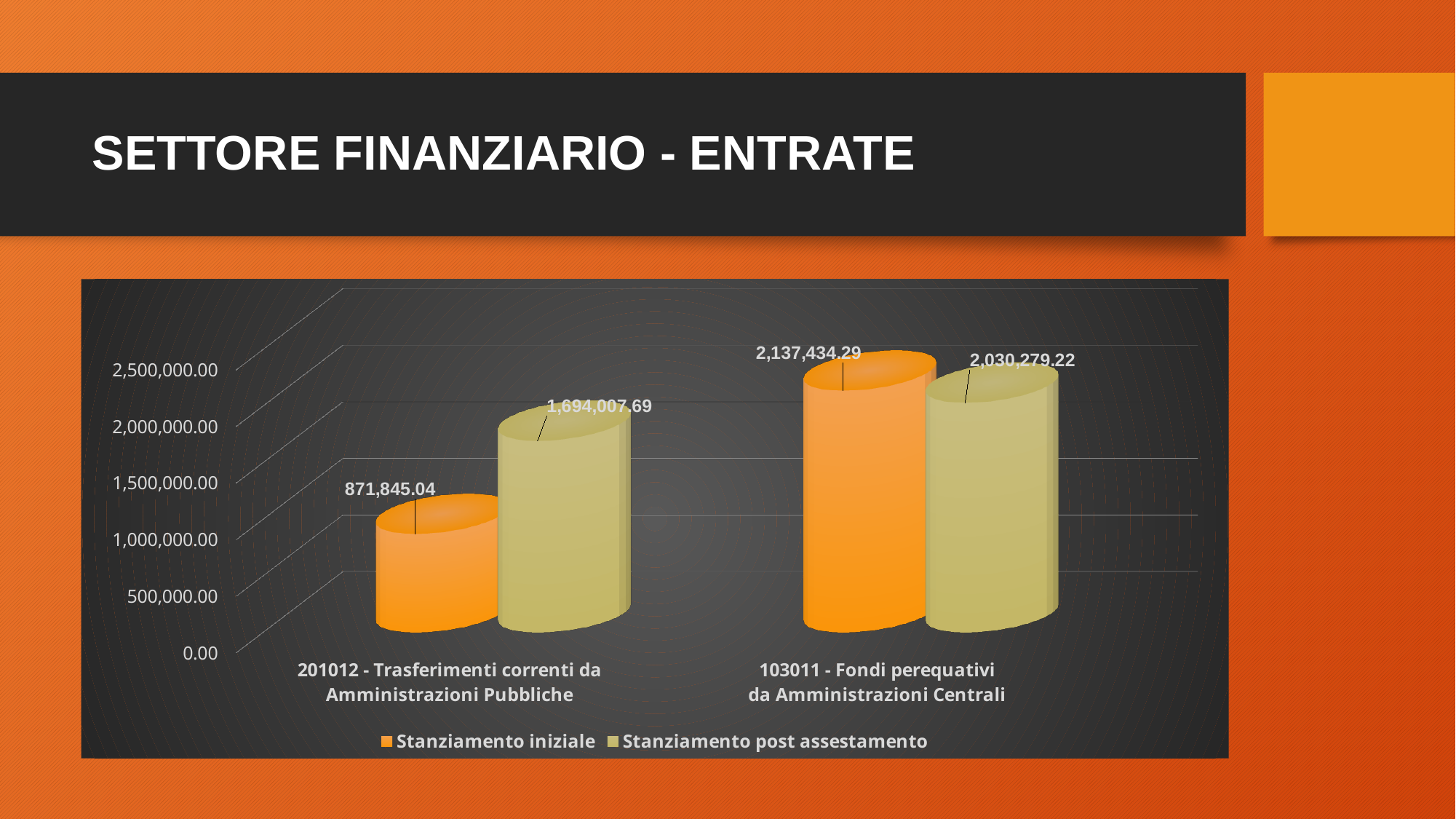
What is the difference between the Stanziamento post assestamento and Stanziamento iniziale values for 201012 - Trasferimenti correnti da Amministrazioni Pubbliche? 822,162.65 For 103011 - Fondi perequativi da Amministrazioni Centrali, which is larger: Stanziamento iniziale or Stanziamento post assestamento? Stanziamento iniziale How many series does the legend list? 2 What is the Stanziamento iniziale value for 103011 - Fondi perequativi da Amministrazioni Centrali? 2,137,434.29 What kind of chart is shown on the slide? bar chart What is the Stanziamento iniziale value for 201012 - Trasferimenti correnti da Amministrazioni Pubbliche? 871,845.04 What is the Stanziamento post assestamento value for 103011 - Fondi perequativi da Amministrazioni Centrali? 2,030,279.22 Is the Stanziamento iniziale value for 201012 - Trasferimenti correnti da Amministrazioni Pubbliche greater or less than 1,000,000.00? less What is the Stanziamento post assestamento value for 201012 - Trasferimenti correnti da Amministrazioni Pubbliche? 1,694,007.69 Which category has the lowest Stanziamento post assestamento value? 201012 - Trasferimenti correnti da Amministrazioni Pubbliche What is the difference between the Stanziamento iniziale and Stanziamento post assestamento values for 103011 - Fondi perequativi da Amministrazioni Centrali? 107,155.07 Which category has the highest Stanziamento iniziale value? 103011 - Fondi perequativi da Amministrazioni Centrali